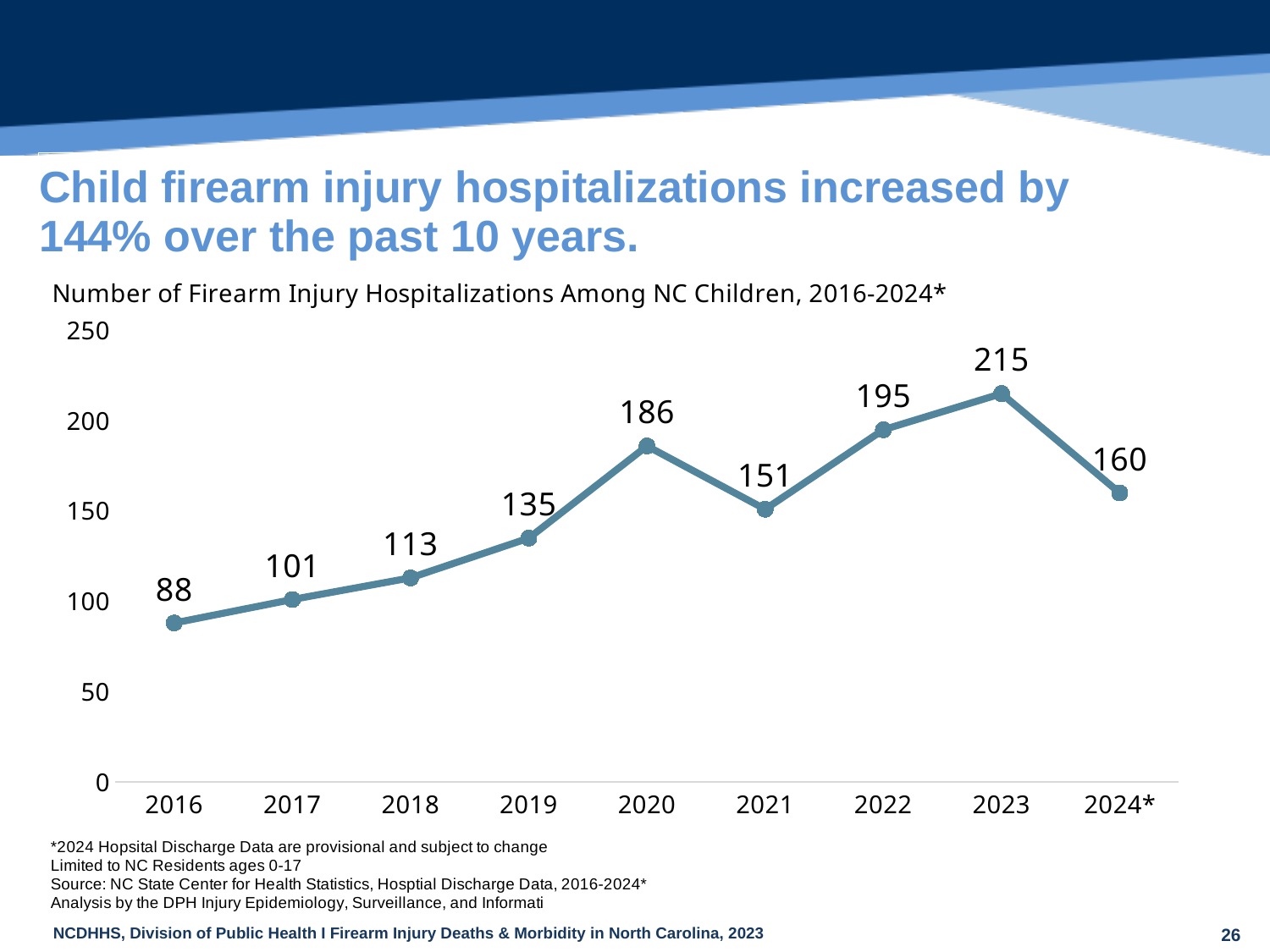
How many years are plotted on the chart? 9 What was the number of firearm injury hospitalizations among NC children in 2016? 88 What is the title of the chart? Number of Firearm Injury Hospitalizations Among NC Children, 2016-2024* Which year had more hospitalizations, 2021 or 2022? 2022 What value is shown for 2020? 186 What type of chart is shown on the slide? line chart What is the difference between the 2020 value and the 2021 value? 35 What is the difference between the 2023 value and the 2016 value? 127 Is the value for 2019 greater or less than 150? less What value is shown for 2024*? 160 Which year has the lowest number of hospitalizations? 2016 Which year has the highest number of hospitalizations? 2023